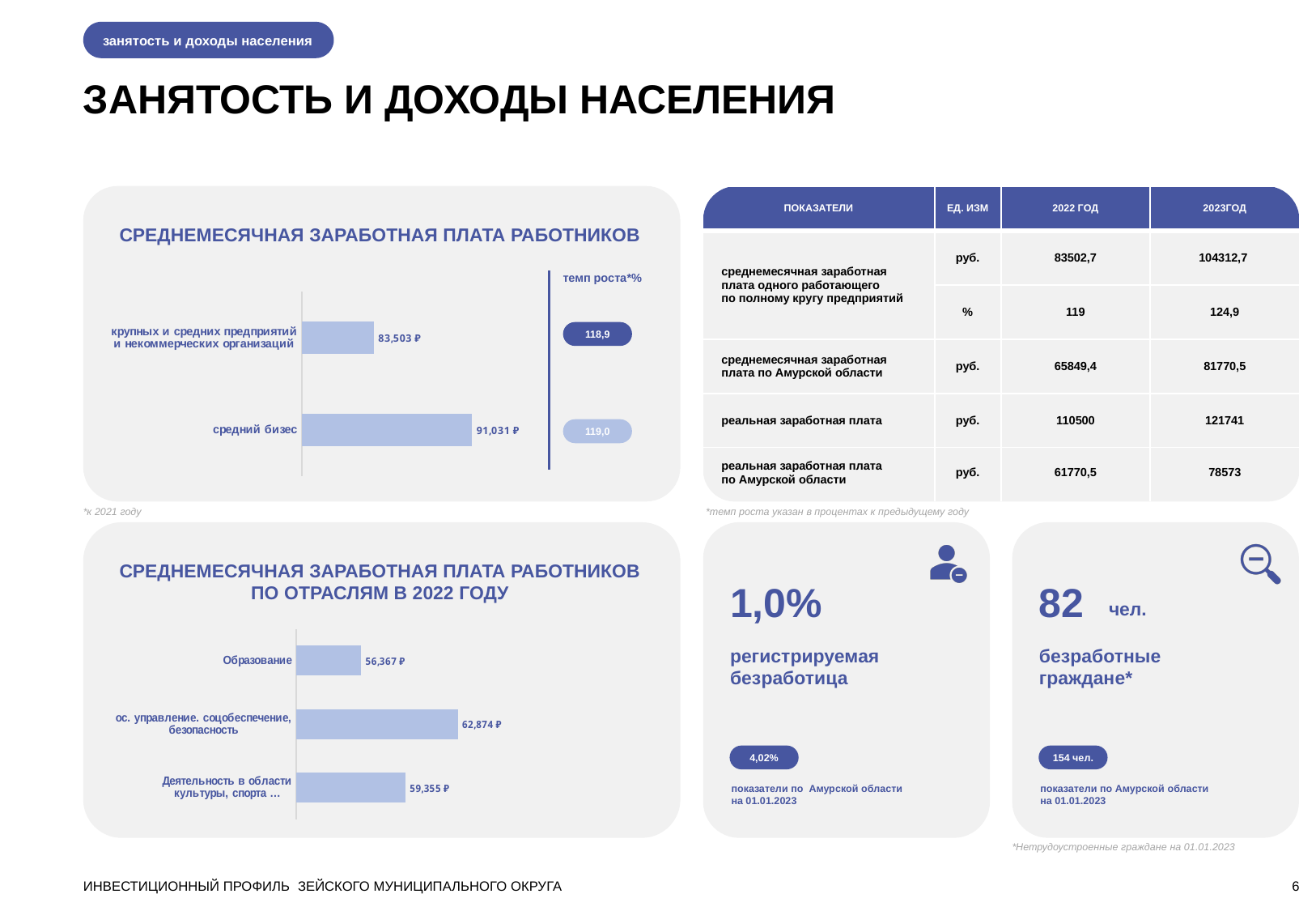
In the chart 'СРЕДНЕМЕСЯЧНАЯ ЗАРАБОТНАЯ ПЛАТА РАБОТНИКОВ', what is the difference between the value for 'средний бизнес' and the value for 'крупных и средних предприятий и некоммерческих организаций'? 7,528 ₽ In the chart 'СРЕДНЕМЕСЯЧНАЯ ЗАРАБОТНАЯ ПЛАТА РАБОТНИКОВ', what is the value for 'крупных и средних предприятий и некоммерческих организаций'? 83,503 ₽ In the chart 'СРЕДНЕМЕСЯЧНАЯ ЗАРАБОТНАЯ ПЛАТА РАБОТНИКОВ ПО ОТРАСЛЯМ В 2022 ГОДУ', which category has the highest value? ос. управление. соцобеспечение, безопасность What kind of chart is 'СРЕДНЕМЕСЯЧНАЯ ЗАРАБОТНАЯ ПЛАТА РАБОТНИКОВ ПО ОТРАСЛЯМ В 2022 ГОДУ'? bar chart In the chart 'СРЕДНЕМЕСЯЧНАЯ ЗАРАБОТНАЯ ПЛАТА РАБОТНИКОВ', what is the value for 'средний бизнес'? 91,031 ₽ In the chart 'СРЕДНЕМЕСЯЧНАЯ ЗАРАБОТНАЯ ПЛАТА РАБОТНИКОВ', how many categories are plotted? 2 In the chart 'СРЕДНЕМЕСЯЧНАЯ ЗАРАБОТНАЯ ПЛАТА РАБОТНИКОВ ПО ОТРАСЛЯМ В 2022 ГОДУ', what is the difference between the value for 'ос. управление. соцобеспечение, безопасность' and the value for 'Образование'? 6,507 ₽ In the chart 'СРЕДНЕМЕСЯЧНАЯ ЗАРАБОТНАЯ ПЛАТА РАБОТНИКОВ', which category has the higher value? средний бизнес In the chart 'СРЕДНЕМЕСЯЧНАЯ ЗАРАБОТНАЯ ПЛАТА РАБОТНИКОВ ПО ОТРАСЛЯМ В 2022 ГОДУ', which category has the lowest value? Образование In the chart 'СРЕДНЕМЕСЯЧНАЯ ЗАРАБОТНАЯ ПЛАТА РАБОТНИКОВ', what is the 'темп роста' value shown for 'средний бизнес'? 119,0 In the chart 'СРЕДНЕМЕСЯЧНАЯ ЗАРАБОТНАЯ ПЛАТА РАБОТНИКОВ ПО ОТРАСЛЯМ В 2022 ГОДУ', how many categories are plotted? 3 In the chart 'СРЕДНЕМЕСЯЧНАЯ ЗАРАБОТНАЯ ПЛАТА РАБОТНИКОВ ПО ОТРАСЛЯМ В 2022 ГОДУ', what is the value for 'Образование'? 56,367 ₽